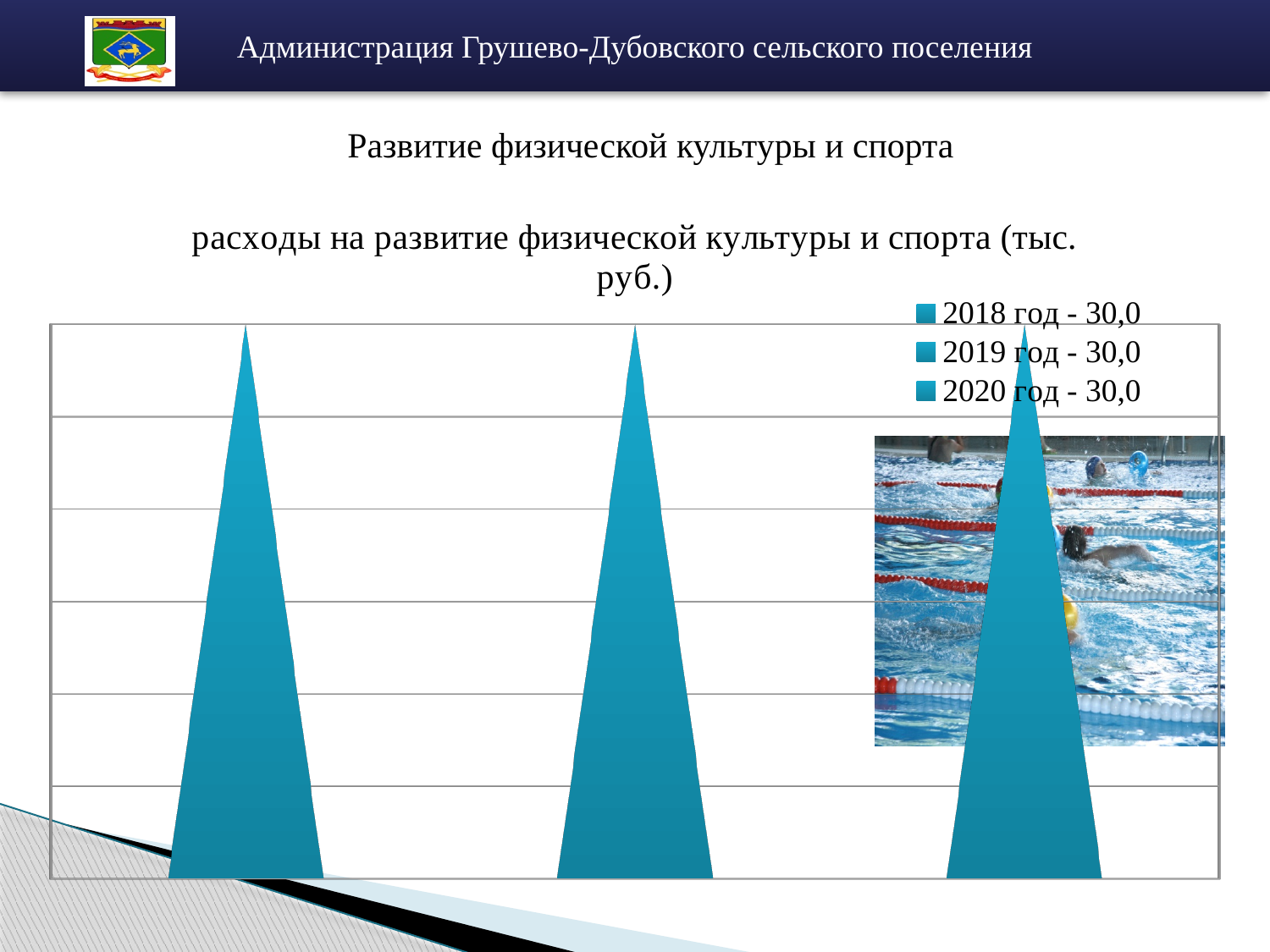
How many bars are plotted on the chart? 3 What is the value for 2018 год according to the legend? 30,0 What is the difference between the values for 2019 год and 2018 год? 0,0 What is the value for 2020 год according to the legend? 30,0 What is the value for 2019 год according to the legend? 30,0 What kind of chart is shown on the slide? bar chart In what units are the expenses in the chart title expressed? тыс. руб. How many entries does the legend list? 3 What is the title of the chart? расходы на развитие физической культуры и спорта (тыс. руб.) Is the value for 2018 год larger than, smaller than or equal to the value for 2020 год? equal Do the values rise, fall or stay the same from 2018 год to 2020 год? stay the same